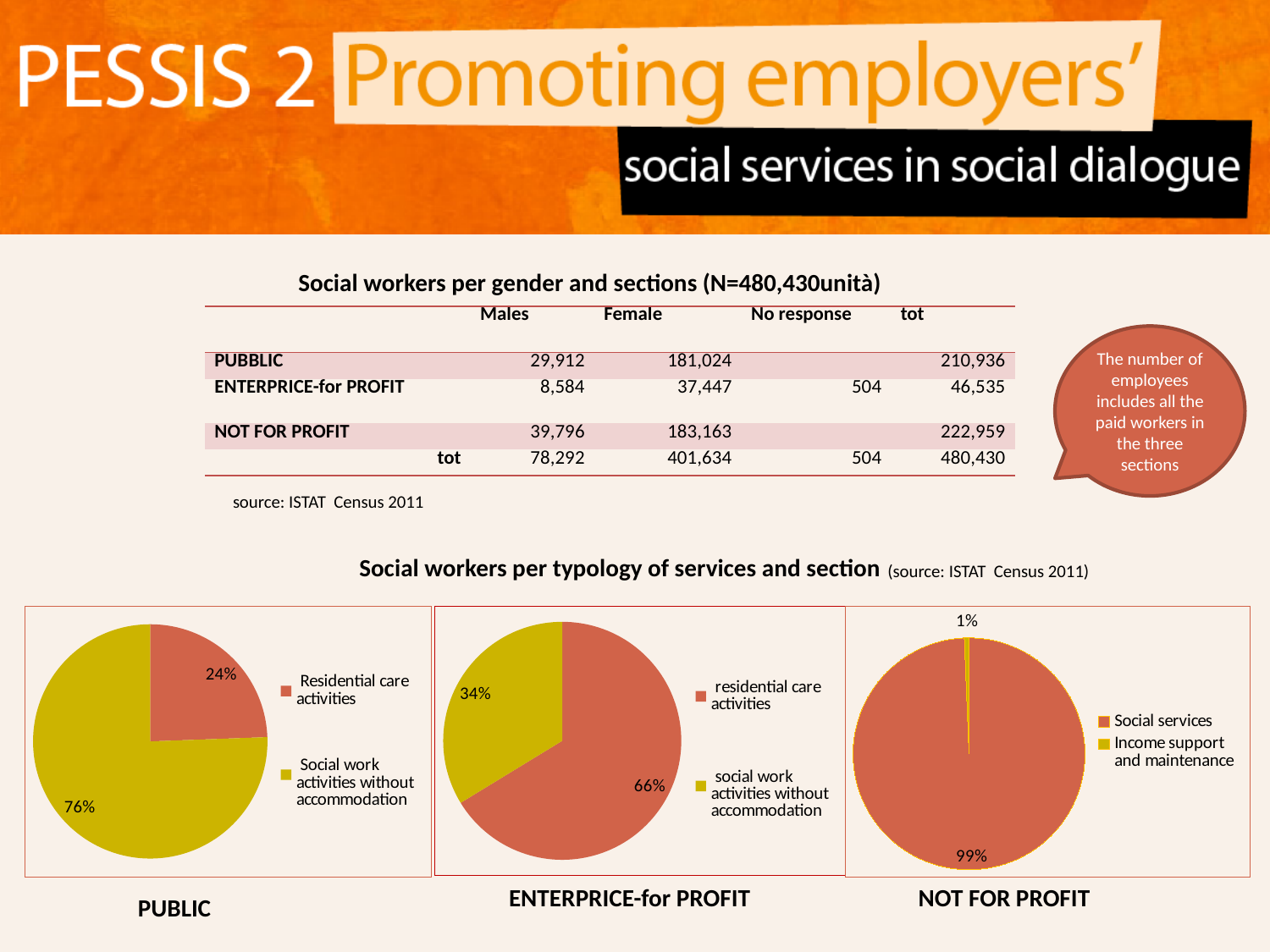
In the NOT FOR PROFIT pie chart, what share is Social services? 99% In the ENTERPRICE-for PROFIT pie chart, what share is social work activities without accommodation? 34% What type of chart is used for the PUBLIC section? Pie chart In the PUBLIC pie chart, what share is Residential care activities? 24% In the ENTERPRICE-for PROFIT pie chart, what share is residential care activities? 66% In the PUBLIC pie chart, what is the difference in percentage points between Social work activities without accommodation and Residential care activities? 52 In the NOT FOR PROFIT pie chart, what share is Income support and maintenance? 1% In the ENTERPRICE-for PROFIT pie chart, which is larger: residential care activities or social work activities without accommodation? residential care activities In the PUBLIC pie chart, which category has the largest share? Social work activities without accommodation In the ENTERPRICE-for PROFIT pie chart, which category has the smallest share? social work activities without accommodation How many categories does the NOT FOR PROFIT pie chart show? 2 In the PUBLIC pie chart, what share is Social work activities without accommodation? 76%